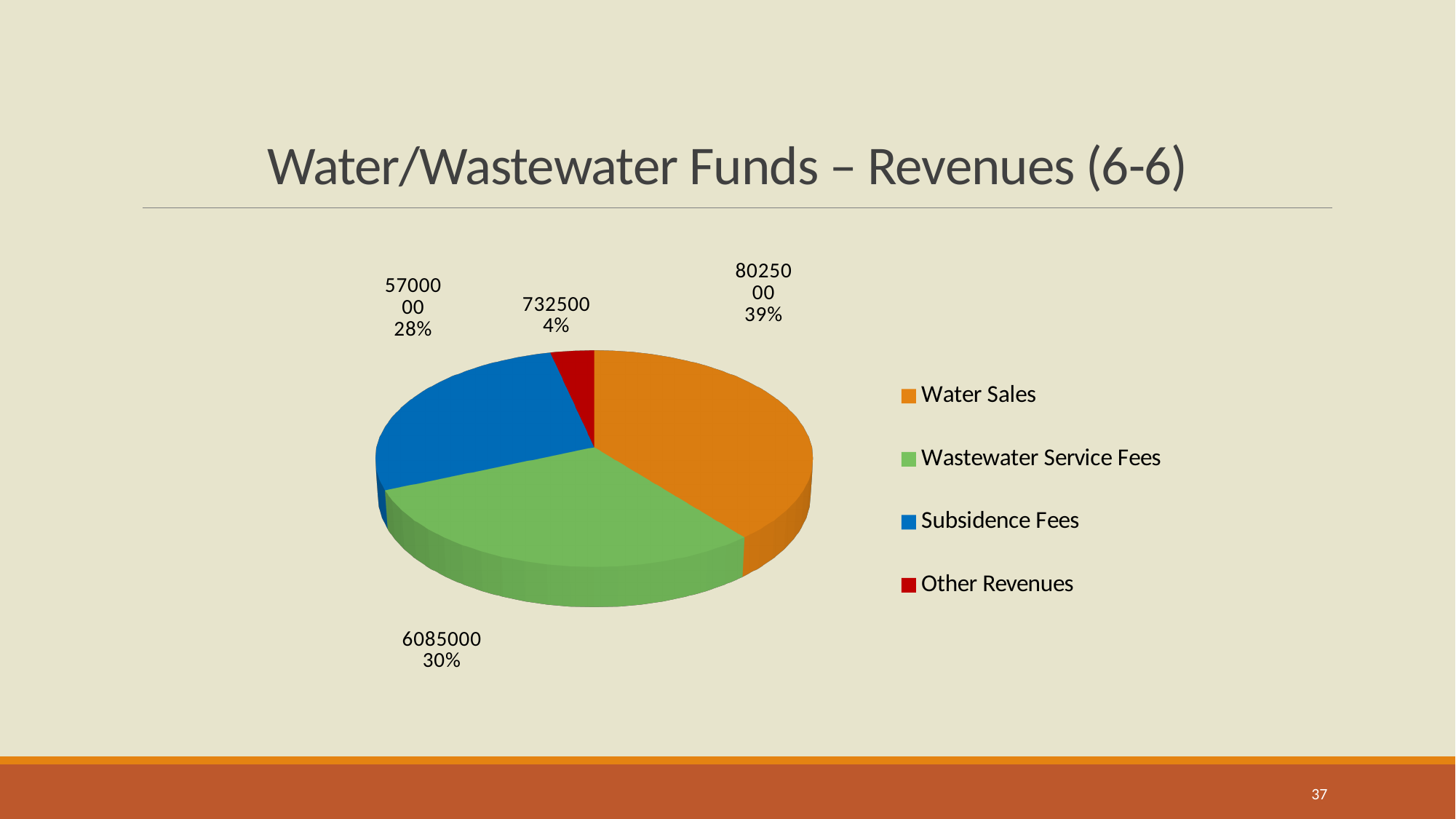
How many entries does the legend list? 4 What share of the pie is Other Revenues? 4% How many slices does the pie chart have? 4 What is the value shown for Other Revenues? 732500 Which category has the smallest slice of the pie? Other Revenues Which category has the largest slice of the pie? Water Sales What share of the pie is Wastewater Service Fees? 30% What is the value shown for Wastewater Service Fees? 6085000 What share of the pie is Water Sales? 39% What kind of chart is shown on the slide? Pie chart What is the title of the chart slide? Water/Wastewater Funds – Revenues (6-6)